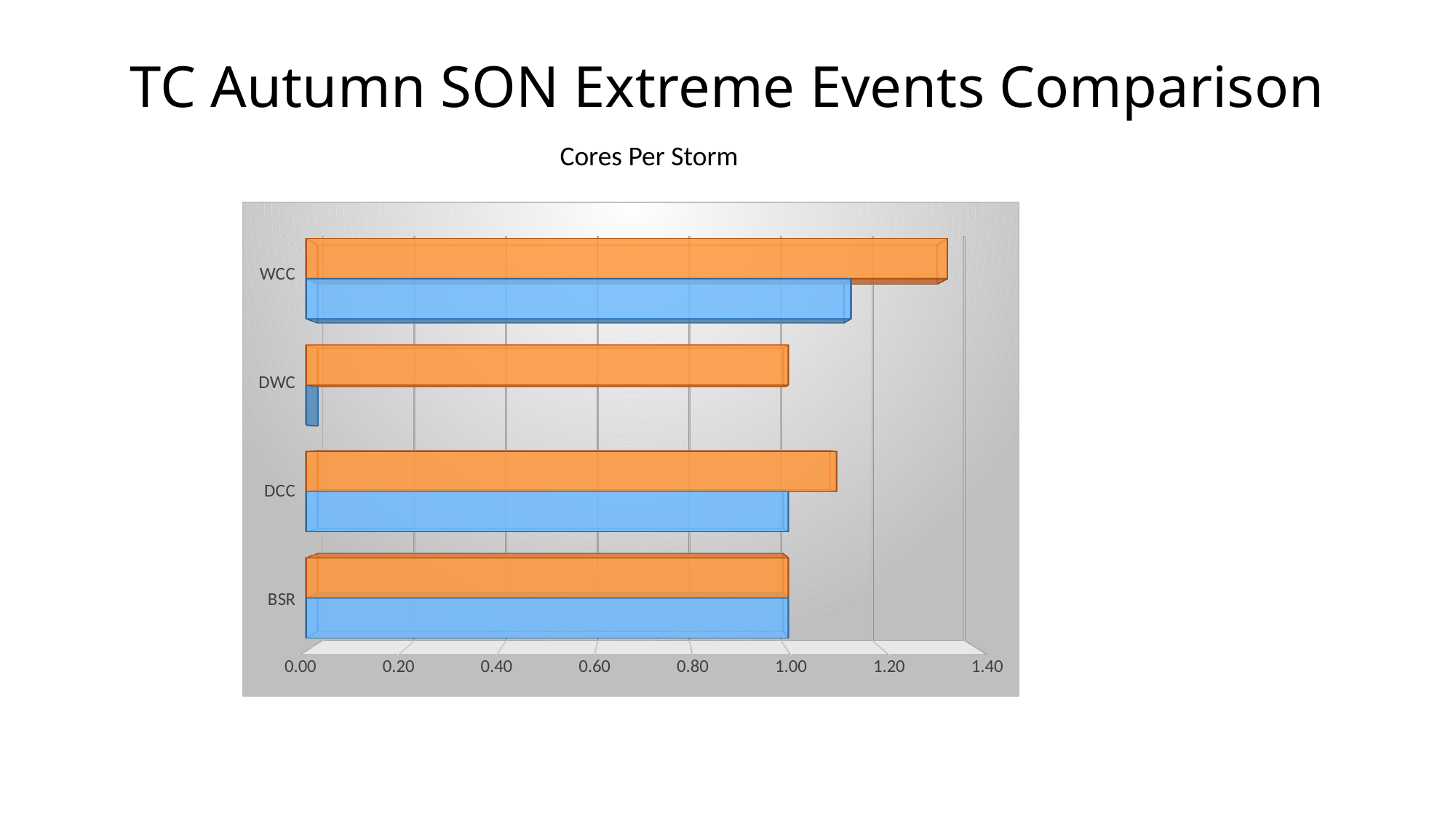
How many categories are shown on the vertical axis of the chart? 4 For DWC, which bar is longer, the orange bar or the blue bar? orange What is the highest value shown on the horizontal axis of the chart? 1.40 What is the title of the chart? Cores Per Storm Which category has the longest orange bar? WCC Is the value of the blue bar for WCC greater or less than 1.00? greater For WCC, which bar is longer, the orange bar or the blue bar? orange Is the value of the blue bar for DWC greater or less than 0.20? less Is the value of the orange bar for DCC greater or less than 1.00? greater Which category has the shortest blue bar? DWC What kind of chart is shown on the slide? bar chart